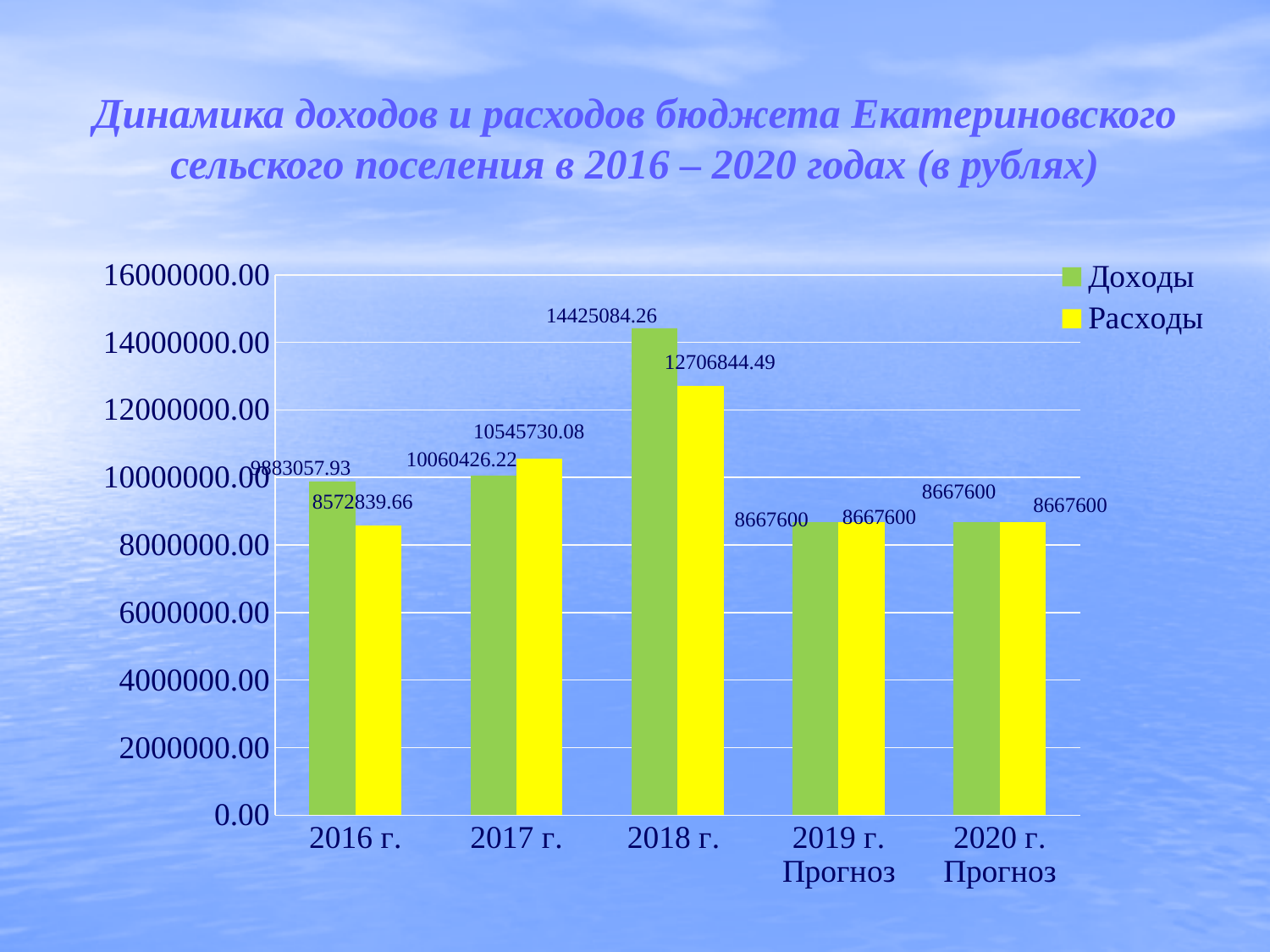
What is the value of Расходы for 2017 г.? 10545730.08 What is the value of Доходы for 2018 г.? 14425084.26 What is the value of Доходы for 2020 г. Прогноз? 8667600 How many year categories are shown on the x axis? 5 Which series is shown in yellow in the legend? Расходы How many series does the legend list? 2 What is the difference between Доходы and Расходы in 2018 г.? 1718239.77 What type of chart is shown on the slide? bar chart In which year is Доходы the highest? 2018 г. In 2017 г., which is larger: Доходы or Расходы? Расходы What is the value of Расходы for 2016 г.? 8572839.66 In which year is Расходы the lowest? 2016 г.